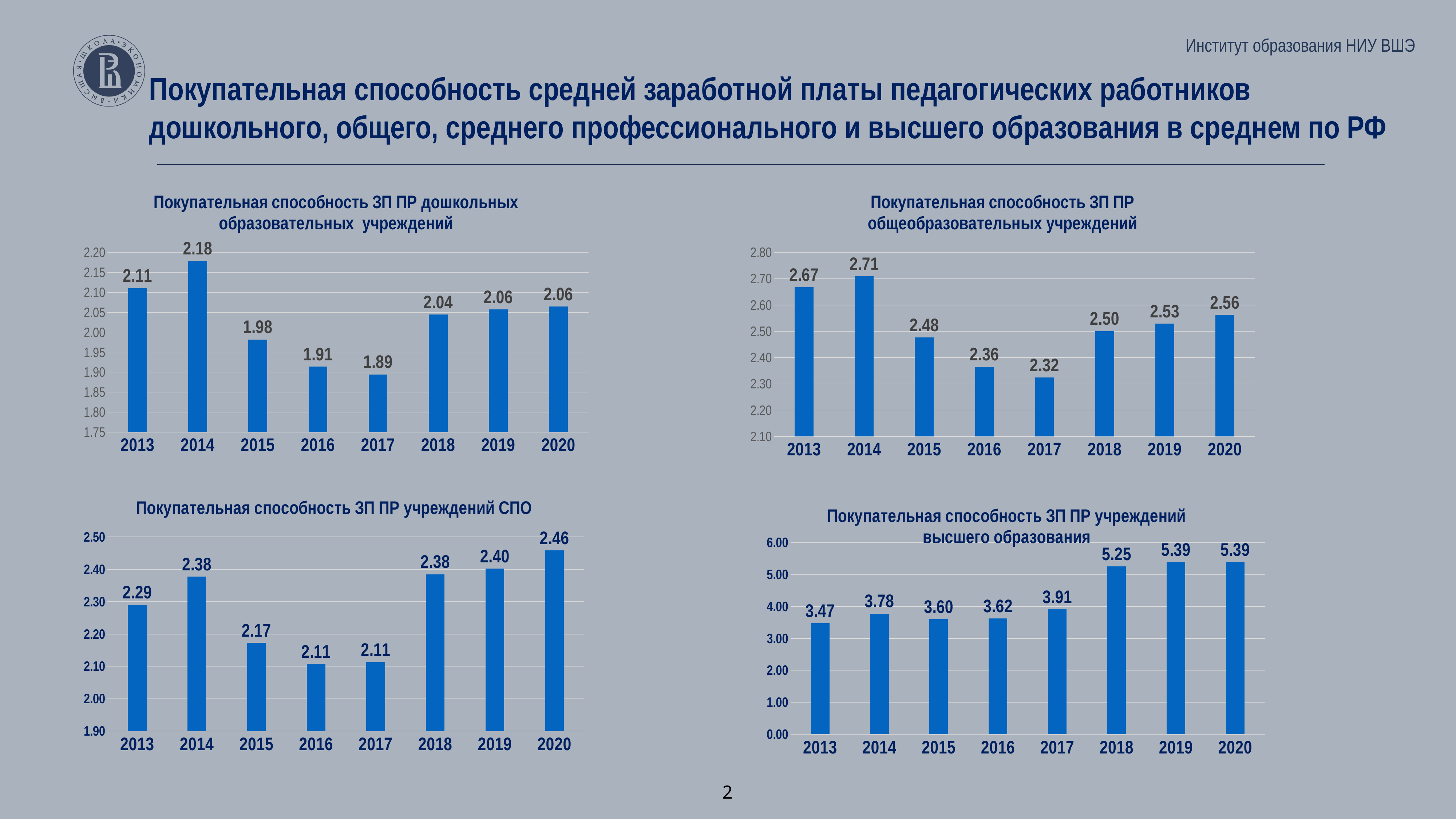
In the top-left chart (Покупательная способность ЗП ПР дошкольных образовательных учреждений), what is the value for 2014? 2.18 In the bottom-left chart (учреждений СПО), which year has the highest value? 2020 In the top-right chart (общеобразовательных учреждений), what is the difference between the 2014 and 2017 values? 0.39 In the bottom-left chart (учреждений СПО), what is the value for 2015? 2.17 What type of chart is the top-left chart (дошкольных образовательных учреждений)? bar chart In the top-right chart (общеобразовательных учреждений), what is the value for 2020? 2.56 In the bottom-right chart (учреждений высшего образования), what is the value for 2018? 5.25 How many years are shown on the x axis of the bottom-right chart (учреждений высшего образования)? 8 In the top-right chart (общеобразовательных учреждений), which year has the highest value? 2014 In the bottom-left chart (учреждений СПО), is the value for 2013 larger or smaller than the value for 2018? smaller In the top-left chart (дошкольных образовательных учреждений), which year has the lowest value? 2017 In the bottom-right chart (учреждений высшего образования), which year has the lowest value? 2013